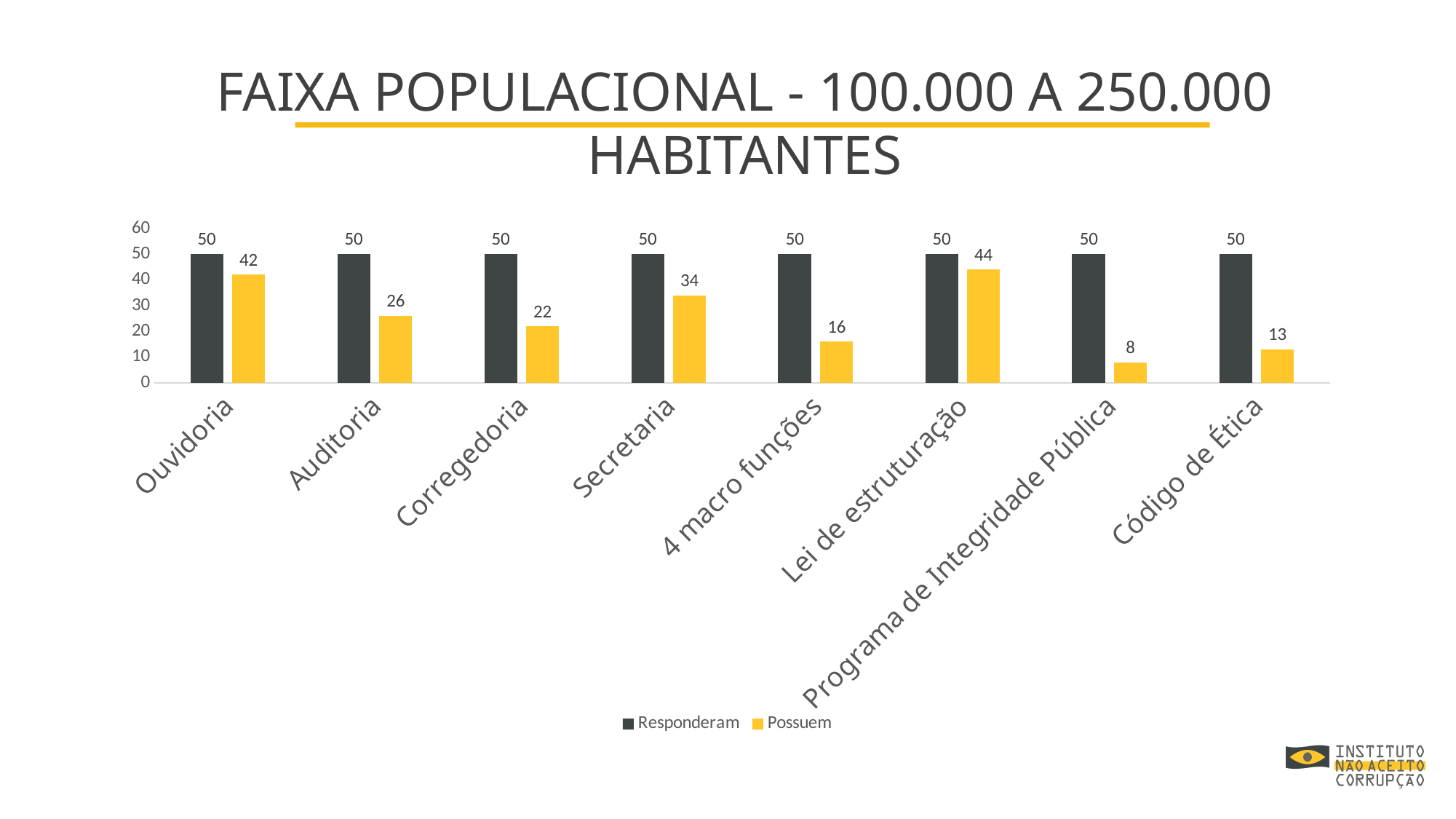
Which is larger, the Possuem value for Secretaria or the Possuem value for Corregedoria? Secretaria Which category has the highest Possuem value? Lei de estruturação Which category has the lowest Possuem value? Programa de Integridade Pública What is the Responderam value for Secretaria? 50 How many series does the legend list? 2 Is the Possuem value for 4 macro funções greater or less than 20? less What is the difference between the Responderam and Possuem values for Auditoria? 24 What kind of chart is shown on the slide? bar chart How many categories are shown on the x axis? 8 What is the Possuem value for Lei de estruturação? 44 What is the Possuem value for Ouvidoria? 42 What colour are the Possuem bars? yellow